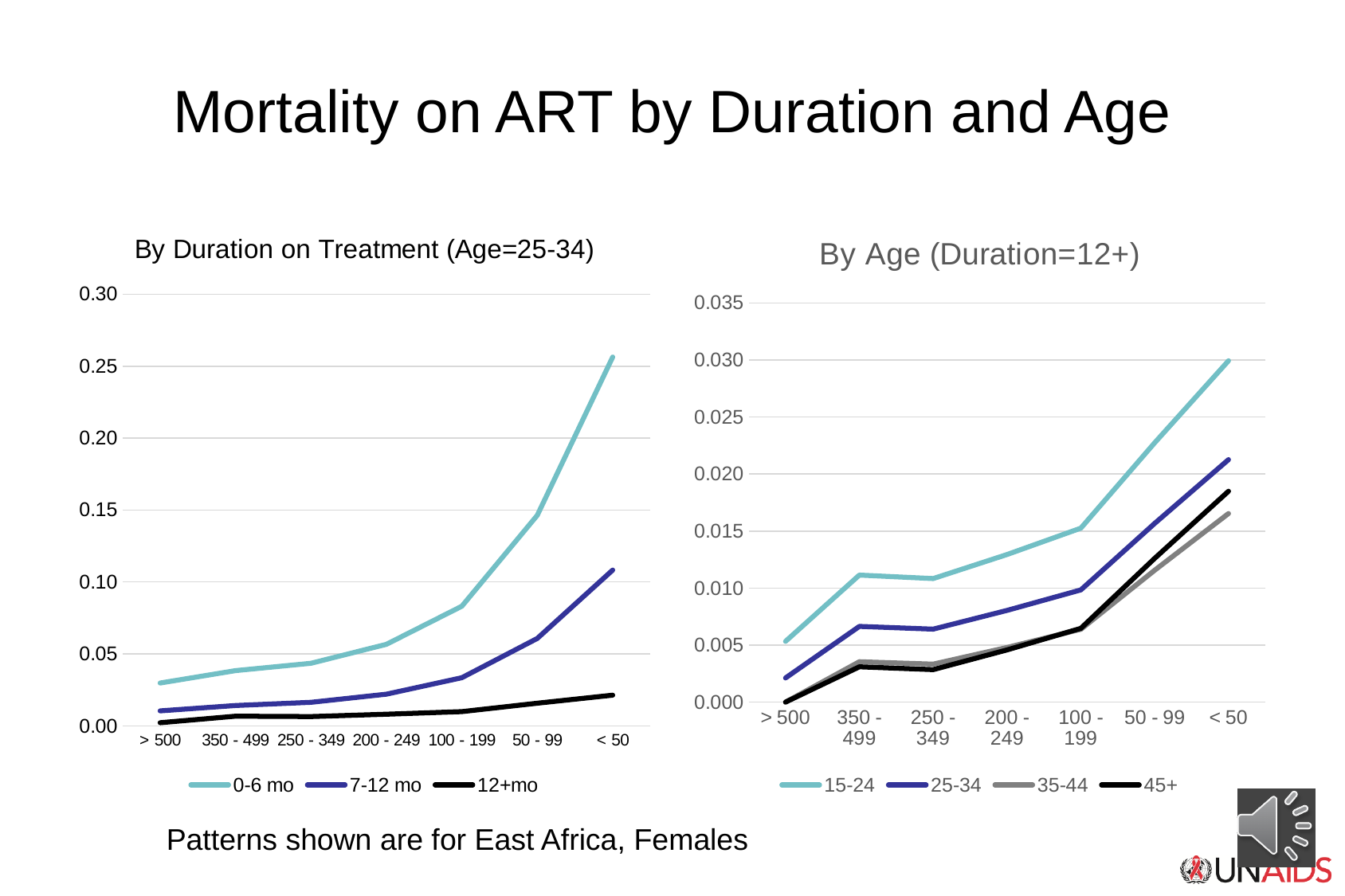
In the right chart, 'By Age (Duration=12+)', which is larger at 350 - 499: the value for 15-24 or the value for 25-34? 15-24 In the left chart, 'By Duration on Treatment (Age=25-34)', which series has the highest value at < 50? 0-6 mo What kind of chart is the left chart, 'By Duration on Treatment (Age=25-34)'? line chart How many series does the legend of the left chart, 'By Duration on Treatment (Age=25-34)', list? 3 In the right chart, 'By Age (Duration=12+)', which series has the lowest value at < 50? 35-44 In the left chart, 'By Duration on Treatment (Age=25-34)', is the value for 12+mo at < 50 greater or less than 0.05? less How many categories are on the x axis of the right chart, 'By Age (Duration=12+)'? 7 In the left chart, 'By Duration on Treatment (Age=25-34)', do the values for 0-6 mo rise or fall moving from > 500 to < 50? rise In the right chart, 'By Age (Duration=12+)', is the value for 15-24 at < 50 greater or less than 0.025? greater How many series does the legend of the right chart, 'By Age (Duration=12+)', list? 4 In the right chart, 'By Age (Duration=12+)', which series has the highest value at < 50? 15-24 In the left chart, 'By Duration on Treatment (Age=25-34)', is the value for 0-6 mo at < 50 greater or less than 0.20? greater